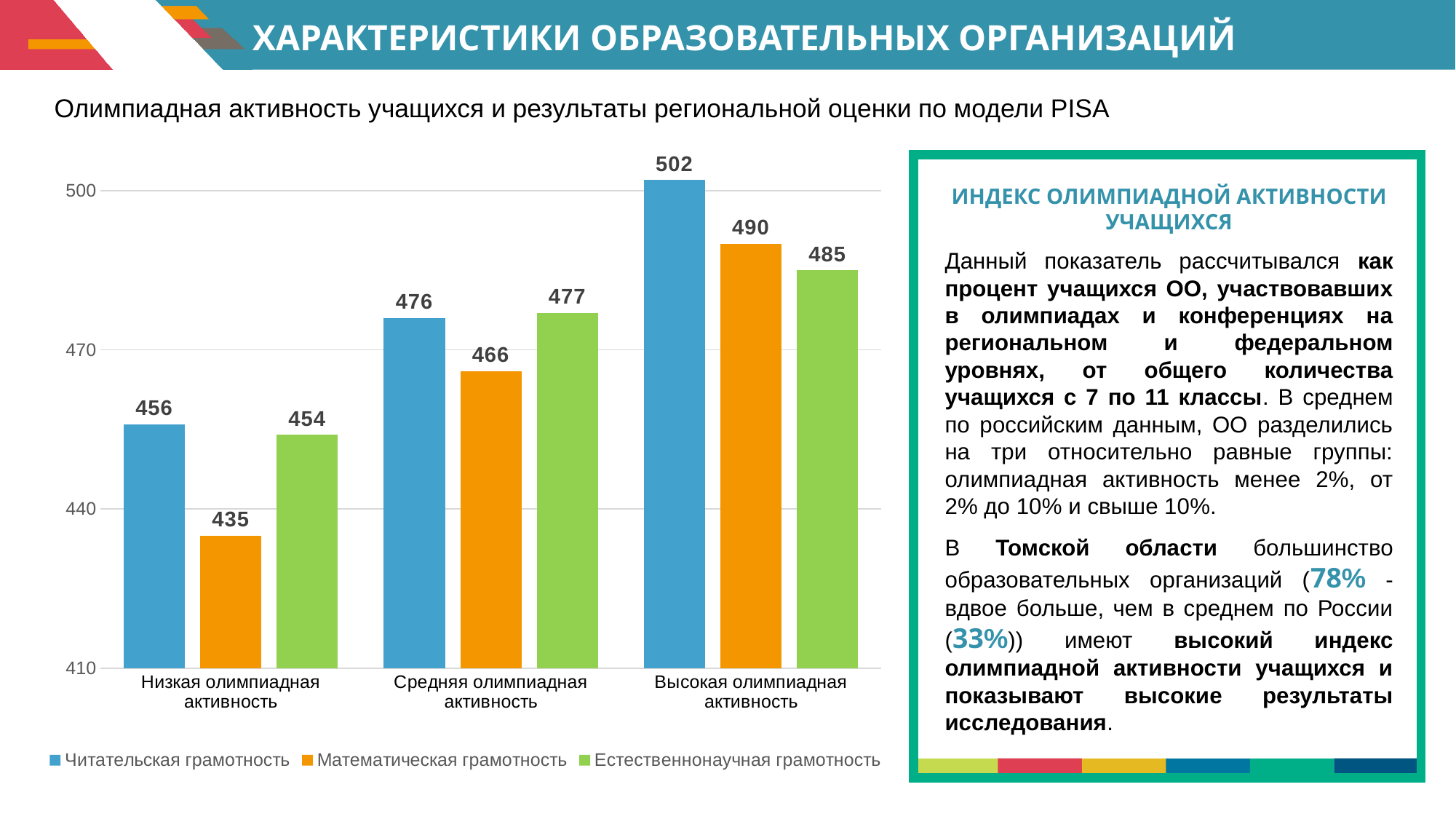
What is the value for Математическая грамотность in the Низкая олимпиадная активность group? 435 What is the value for Читательская грамотность in the Высокая олимпиадная активность group? 502 Which series has the lowest value in the Низкая олимпиадная активность group? Математическая грамотность Is the value for Математическая грамотность in the Средняя олимпиадная активность group greater or less than 470? less What is the value for Естественнонаучная грамотность in the Средняя олимпиадная активность group? 477 Which group has the highest value for Математическая грамотность? Высокая олимпиадная активность How many series does the legend list? 3 Do the values for Читательская грамотность rise or fall from Низкая to Высокая олимпиадная активность? rise What is the difference between Читательская грамотность in the Высокая and Низкая олимпиадная активность groups? 46 How many category groups are shown on the x axis? 3 What kind of chart is shown on the slide? bar chart Which is larger: Естественнонаучная грамотность in the Высокая group or Математическая грамотность in the Высокая group? Математическая грамотность